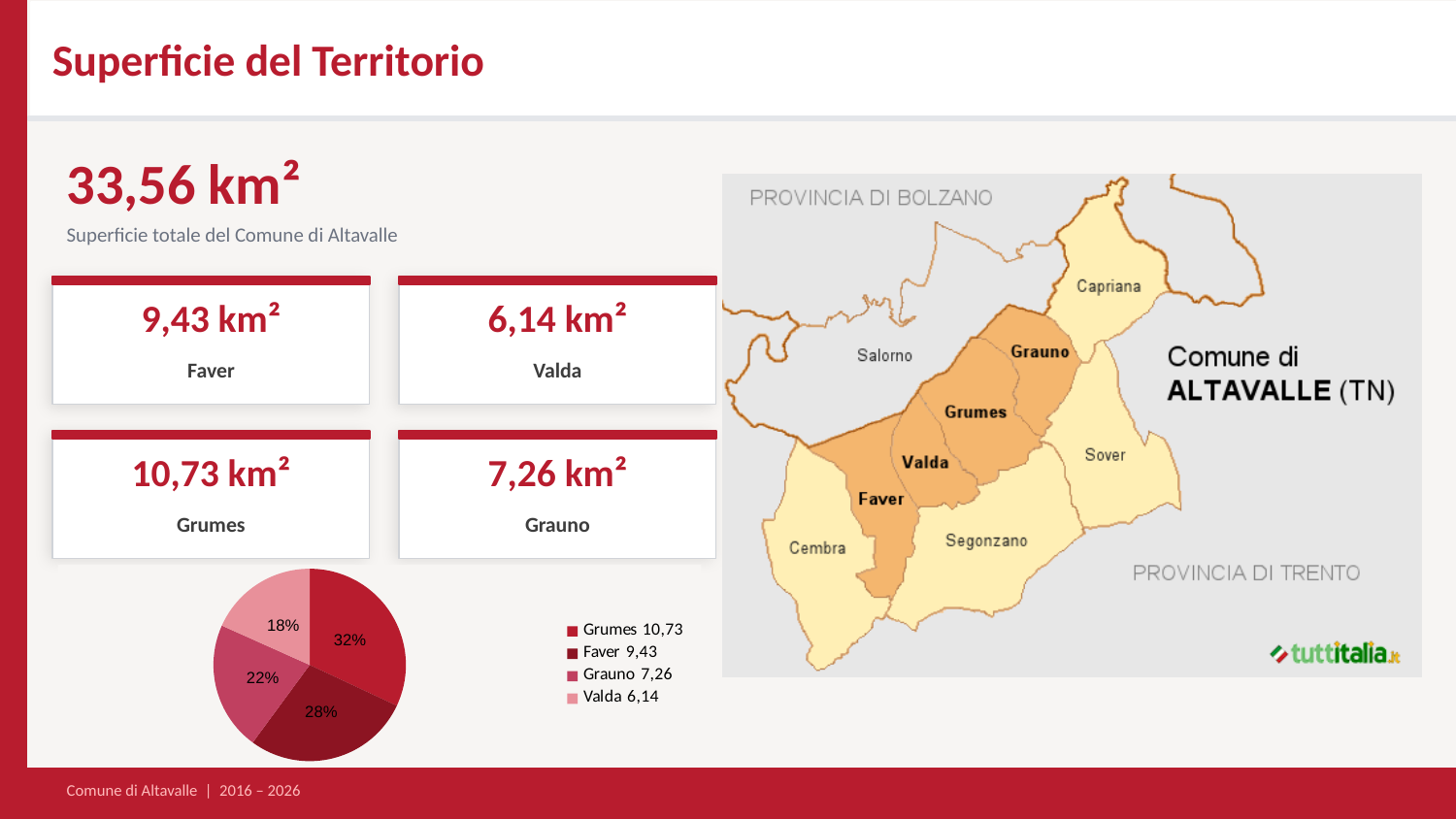
What share of the pie does Valda represent? 18% Which category has the largest slice of the pie? Grumes What kind of chart is shown on the slide? pie chart What value does the legend give for Faver? 9,43 What value does the legend give for Grumes? 10,73 How many entries does the pie chart's legend list? 4 What is the difference between the legend values for Grumes and Valda? 4,59 Which category has the smallest slice of the pie? Valda How many slices does the pie chart have? 4 What share of the pie does Grauno represent? 22% Which is larger, the value for Faver or the value for Grauno? Faver What share of the pie does Grumes represent? 32%